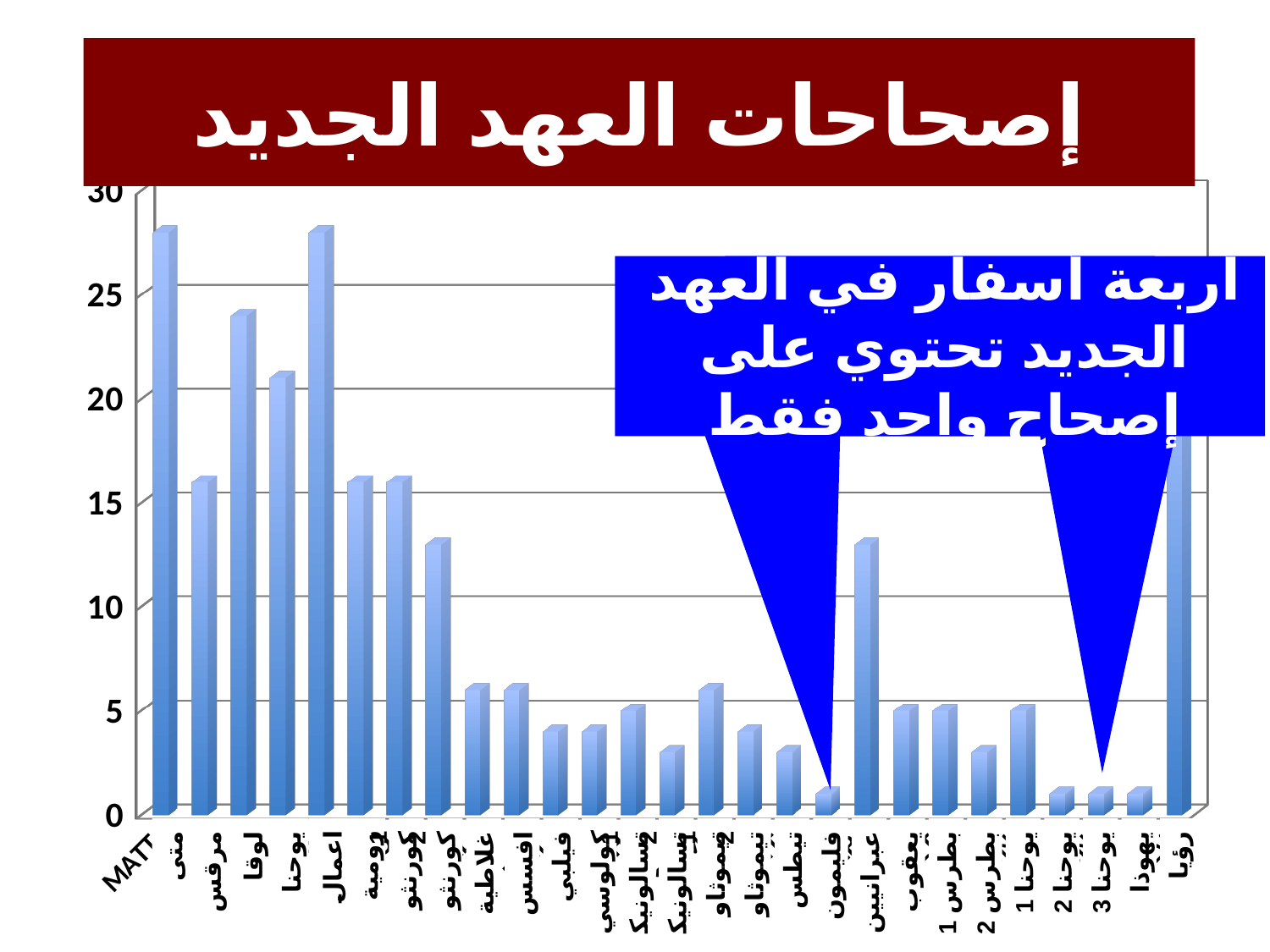
Which has the larger value, رؤيا or عبرانيين? رؤيا Which has the larger value, لوقا or مرقس? لوقا What is the highest value shown on the vertical axis of the chart? 30 What kind of chart is shown on the slide? bar chart Which has the larger value, عبرانيين or يعقوب? عبرانيين Is the value for متى greater or less than 25? greater Is the value for فليمون greater or less than 5? less Is the value for عبرانيين greater or less than 10? greater What is the title of the chart on the slide? إصحاحات العهد الجديد